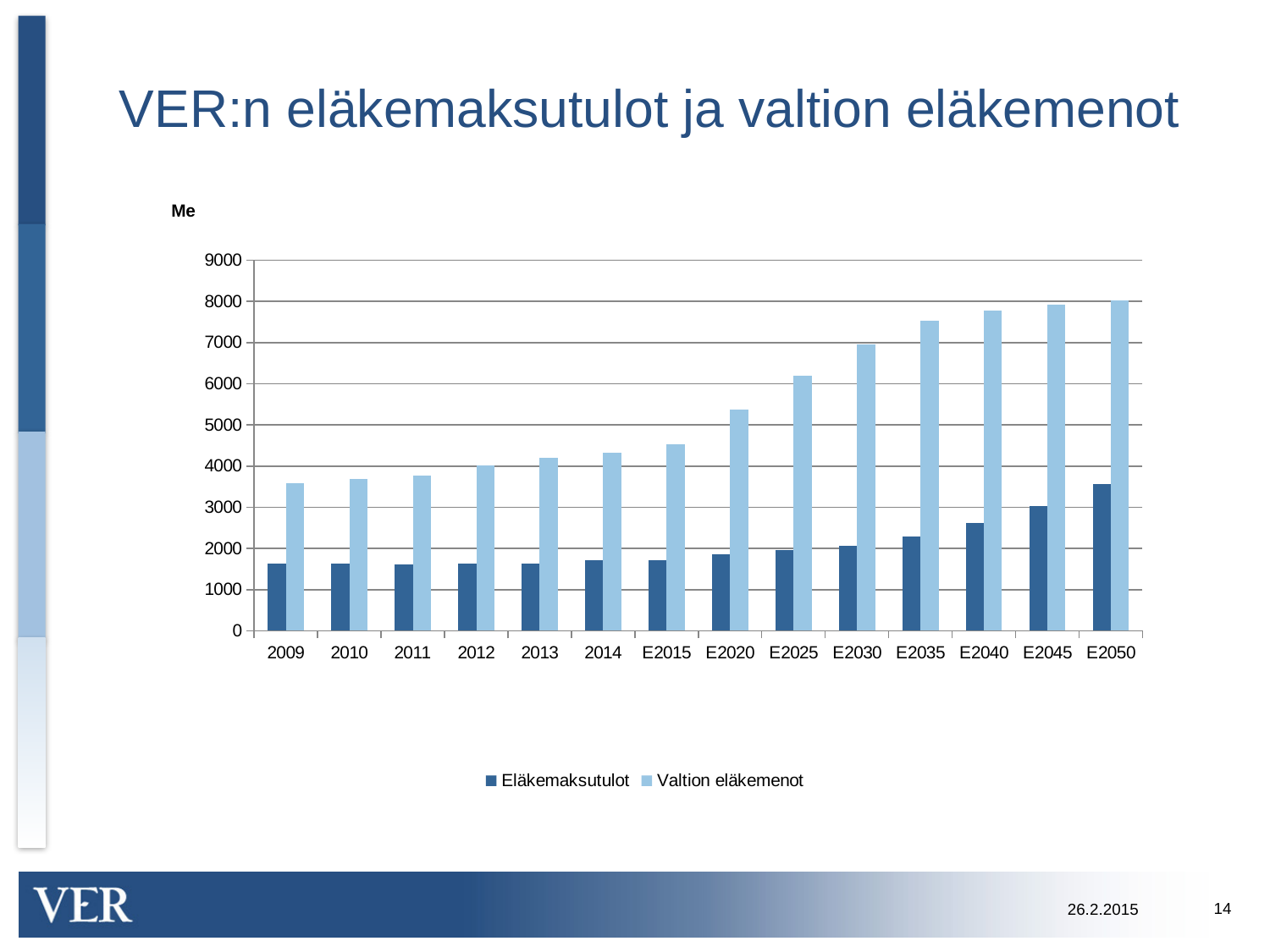
Is the value of Eläkemaksutulot for 2009 greater or less than 2000? less Is the value of Valtion eläkemenot for E2020 greater or less than 5000? greater Is the value of Valtion eläkemenot for 2009 greater or less than 4000? less What kind of chart is shown on the slide? bar chart Do the values of Valtion eläkemenot rise or fall from 2009 to E2050? rise How many series does the legend list? 2 In which category is Eläkemaksutulot highest? E2050 For E2050, which is larger: Eläkemaksutulot or Valtion eläkemenot? Valtion eläkemenot How many categories are shown on the x axis? 14 In which category is Valtion eläkemenot lowest? 2009